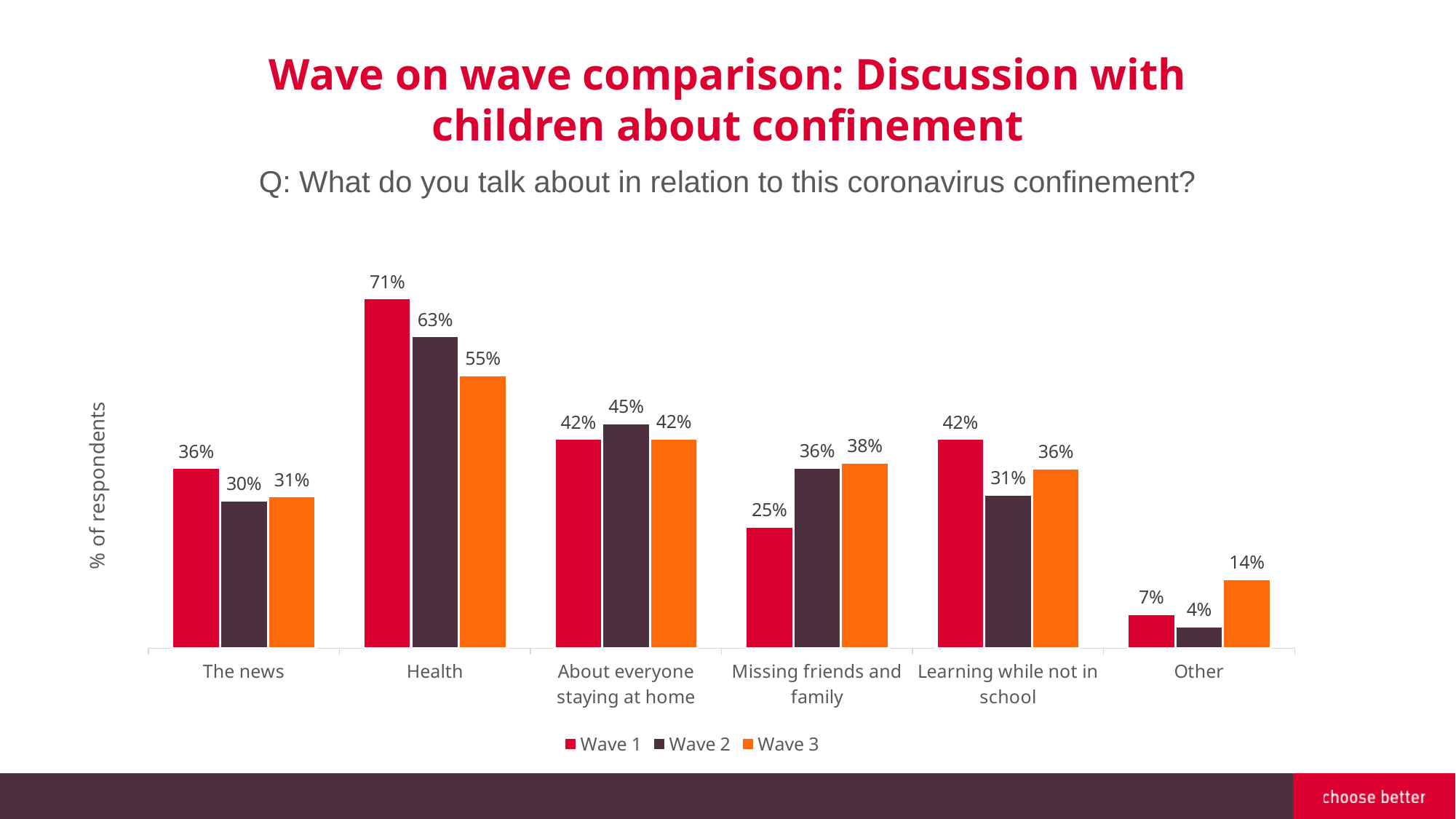
Which category has the lowest Wave 2 value? Other How many categories are shown on the x axis? 6 Which is larger for Learning while not in school: the Wave 1 value or the Wave 2 value? Wave 1 How many series does the legend list? 3 What kind of chart is shown on the slide? Bar chart What is the Wave 2 value for Missing friends and family? 36% Do the values for Health rise or fall from Wave 1 to Wave 3? Fall What is the Wave 1 value for Health? 71% What is the y-axis label of the chart? % of respondents What is the difference between the Wave 1 and Wave 3 values for Health? 16% Which category has the highest Wave 1 value? Health What is the Wave 3 value for Other? 14%